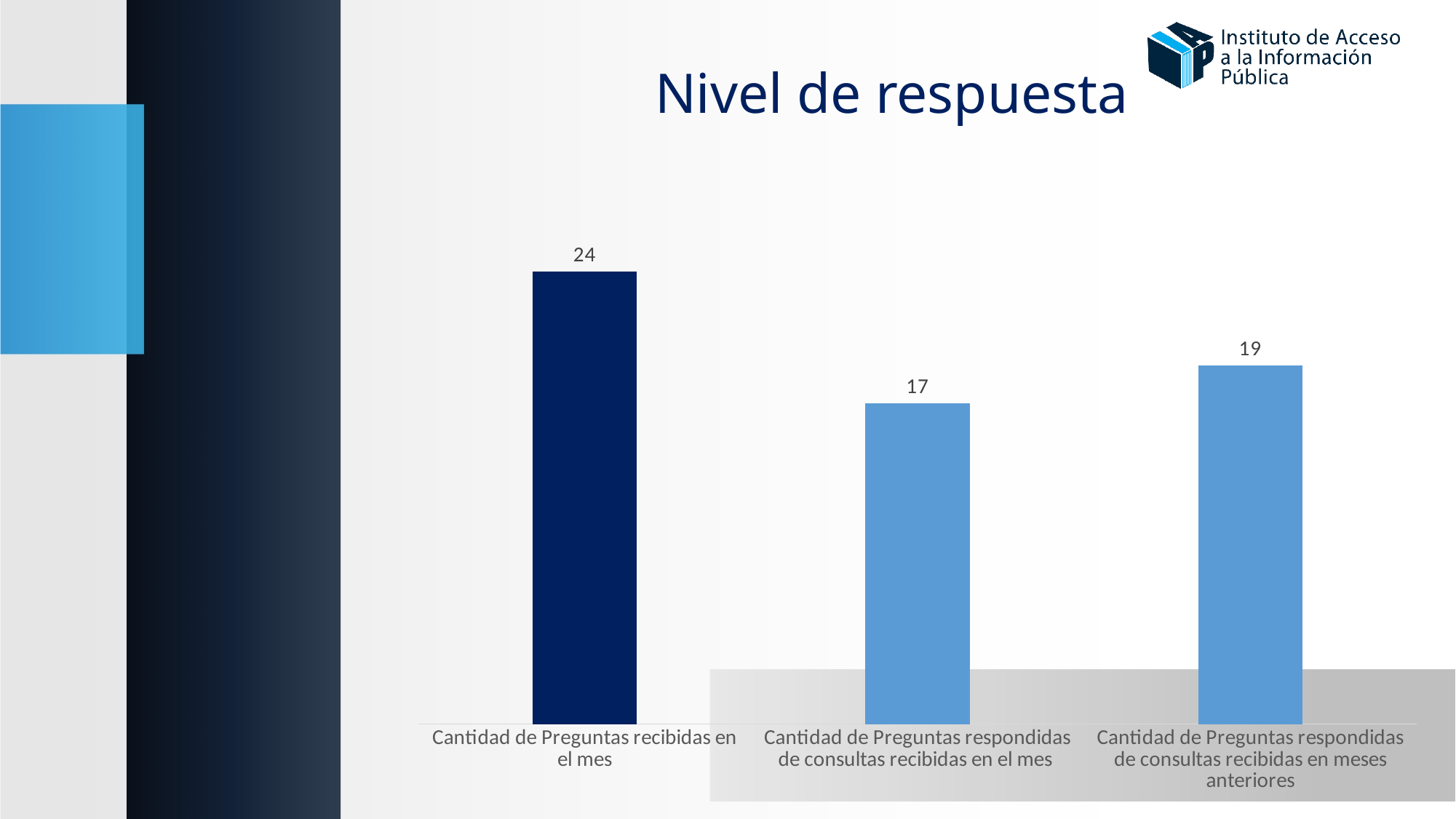
What is the value for "Cantidad de Preguntas recibidas en el mes"? 24 Which is larger: "Cantidad de Preguntas respondidas de consultas recibidas en el mes" or "Cantidad de Preguntas respondidas de consultas recibidas en meses anteriores"? Cantidad de Preguntas respondidas de consultas recibidas en meses anteriores What kind of chart is shown on the slide? Bar chart How many categories are shown in the chart? 3 Which bar is shown in a darker blue than the others? Cantidad de Preguntas recibidas en el mes Which category has the lowest value? Cantidad de Preguntas respondidas de consultas recibidas en el mes What is the value for "Cantidad de Preguntas respondidas de consultas recibidas en meses anteriores"? 19 What is the title of the slide? Nivel de respuesta What is the value for "Cantidad de Preguntas respondidas de consultas recibidas en el mes"? 17 What is the difference between "Cantidad de Preguntas recibidas en el mes" and "Cantidad de Preguntas respondidas de consultas recibidas en el mes"? 7 What is the difference between "Cantidad de Preguntas respondidas de consultas recibidas en meses anteriores" and "Cantidad de Preguntas respondidas de consultas recibidas en el mes"? 2 Which category has the highest value? Cantidad de Preguntas recibidas en el mes